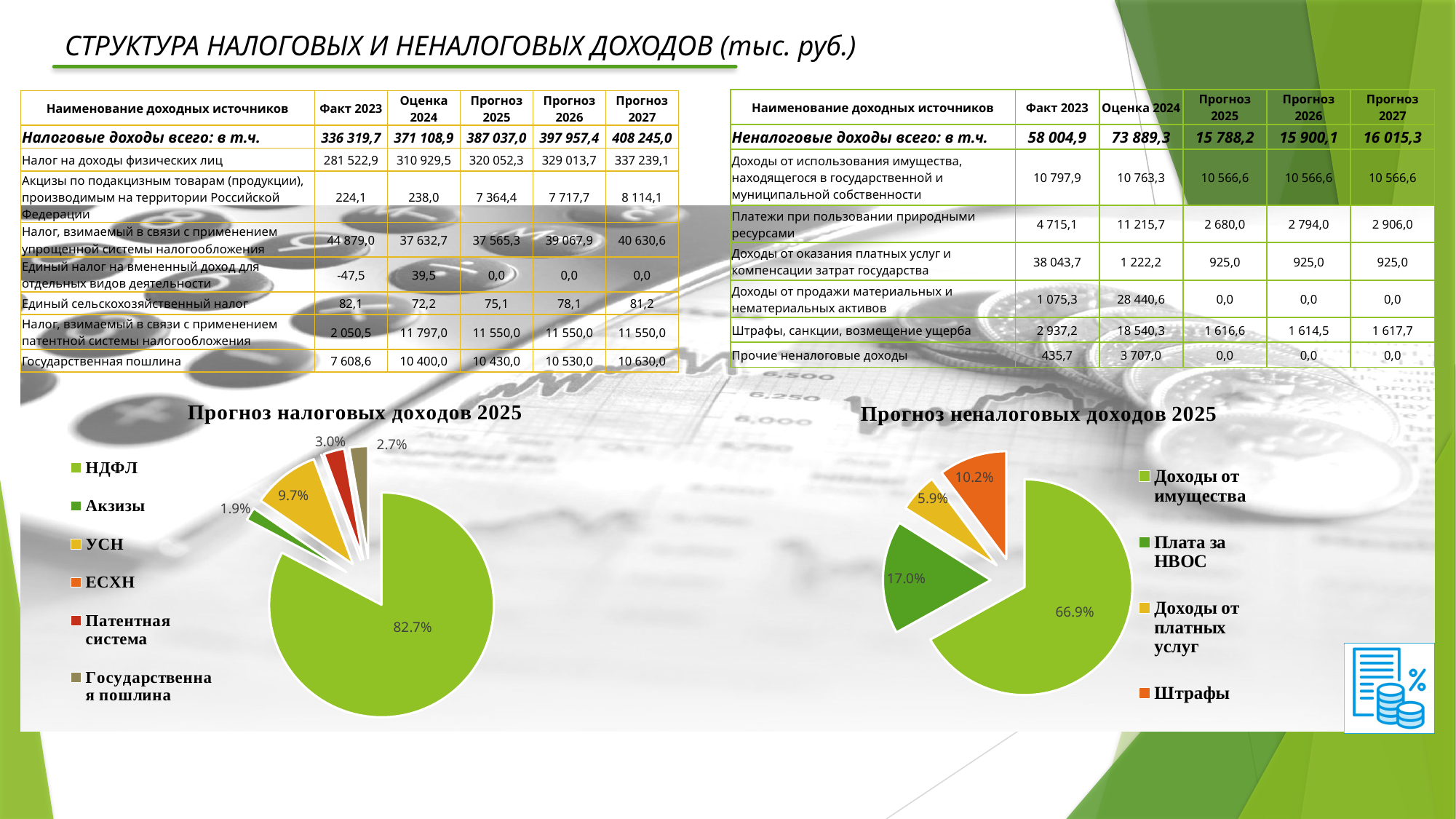
In the chart titled "Прогноз налоговых доходов 2025", how many entries does the legend list? 6 In the chart titled "Прогноз неналоговых доходов 2025", what share does Штрафы have? 10.2% In the chart titled "Прогноз налоговых доходов 2025", what share does НДФЛ have? 82.7% In the chart titled "Прогноз налоговых доходов 2025", which category has the largest slice? НДФЛ In the chart titled "Прогноз неналоговых доходов 2025", what share does Доходы от имущества have? 66.9% In the chart titled "Прогноз неналоговых доходов 2025", what is the difference between the shares of Плата за НВОС and Штрафы? 6.8% In the chart titled "Прогноз неналоговых доходов 2025", which category has the smallest slice? Доходы от платных услуг In the chart titled "Прогноз налоговых доходов 2025", what share does УСН have? 9.7% In the chart titled "Прогноз неналоговых доходов 2025", what share does Плата за НВОС have? 17.0% In the chart titled "Прогноз налоговых доходов 2025", which is larger: УСН or Акцизы? УСН What kind of chart is "Прогноз налоговых доходов 2025"? Pie chart In the chart titled "Прогноз налоговых доходов 2025", what share does Патентная система have? 3.0%